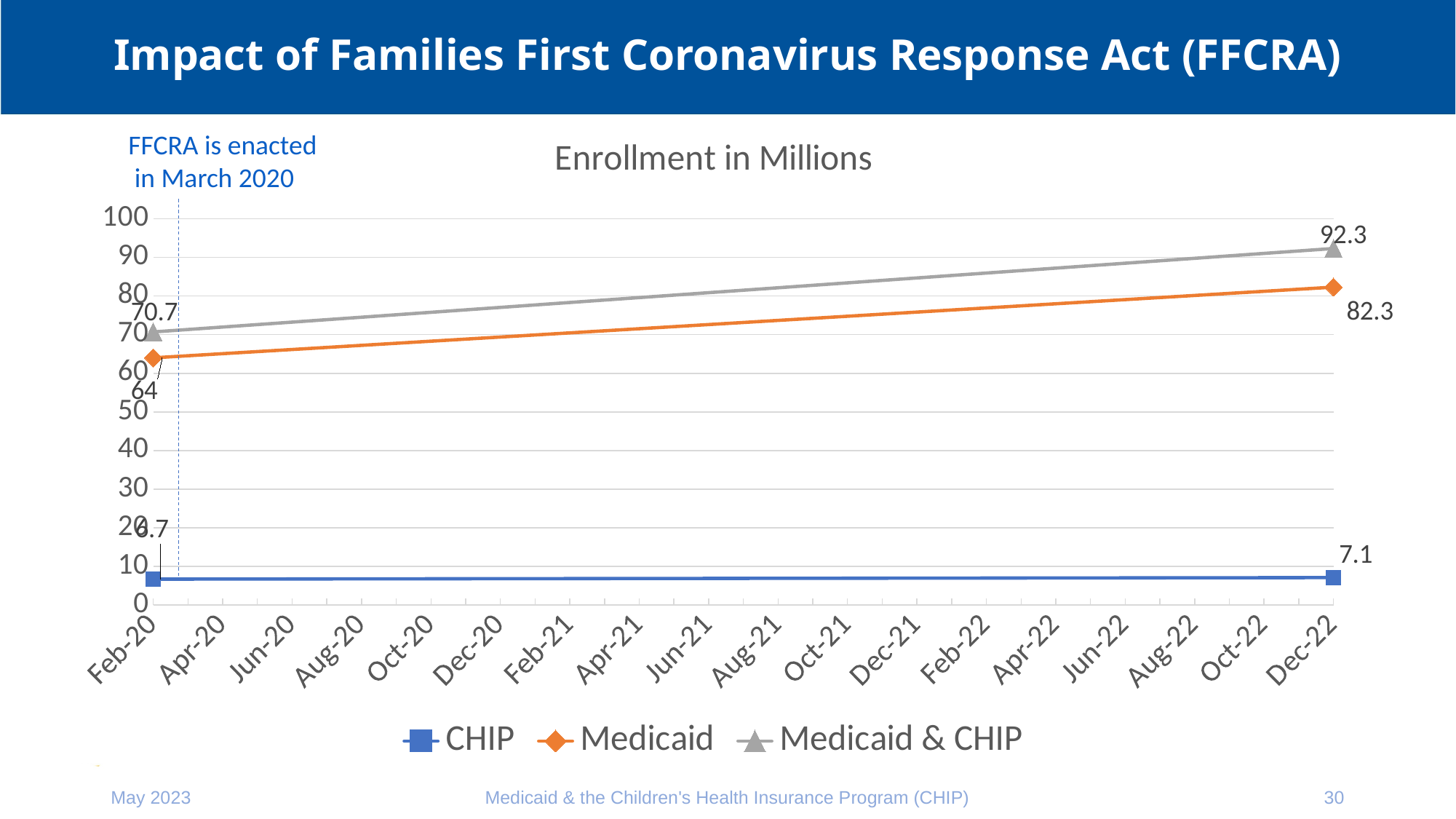
By how much did Medicaid enrollment increase from Feb-20 to Dec-22? 18.3 What is the title of the chart? Enrollment in Millions Does the Medicaid line rise or fall from Feb-20 to Dec-22? Rises What is the CHIP enrollment value at Dec-22? 7.1 What is the Medicaid enrollment value at Feb-20? 64 What is the Medicaid enrollment value at Dec-22? 82.3 What is the Medicaid & CHIP enrollment value at Feb-20? 70.7 What is the Medicaid & CHIP enrollment value at Dec-22? 92.3 Which series has the highest value at Dec-22? Medicaid & CHIP By how much did Medicaid & CHIP enrollment increase from Feb-20 to Dec-22? 21.6 What kind of chart is shown on the slide? Line chart How many series does the legend list? 3